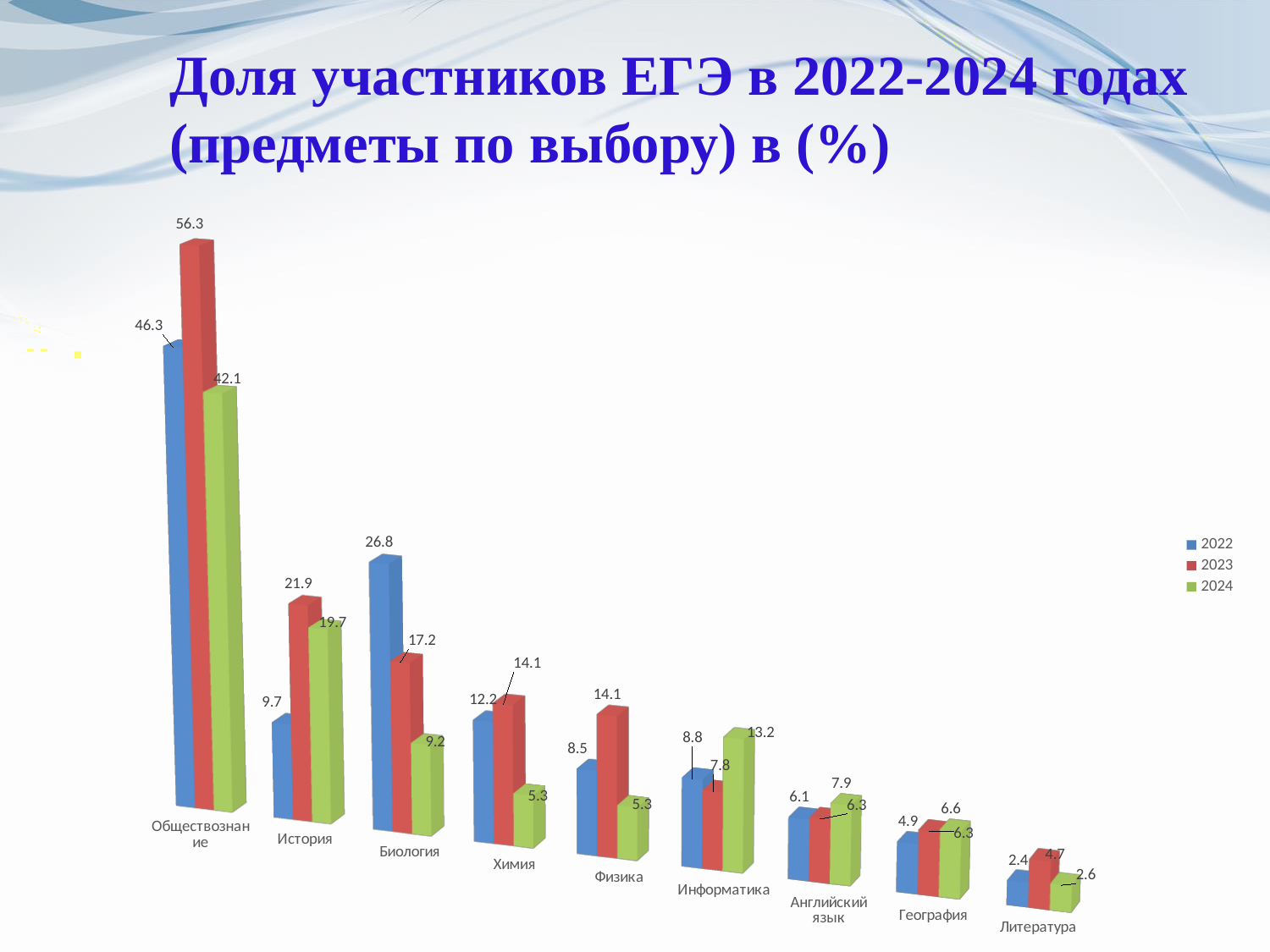
What is the value for Информатика in the 2024 series? 13.2 How many categories are shown on the x axis? 9 Which category has the highest value in the 2022 series? Обществознание What is the difference between the 2023 and 2022 values for История? 12.2 Which category has the lowest value in the 2024 series? Литература How many series does the legend list? 3 What is the value for Обществознание in the 2023 series? 56.3 Do the values for Биология rise or fall from 2022 to 2024? fall What kind of chart is shown on the slide? bar chart What is the value for Литература in the 2023 series? 4.7 What is the value for Биология in the 2022 series? 26.8 Which is larger for Физика: the 2022 value or the 2023 value? 2023